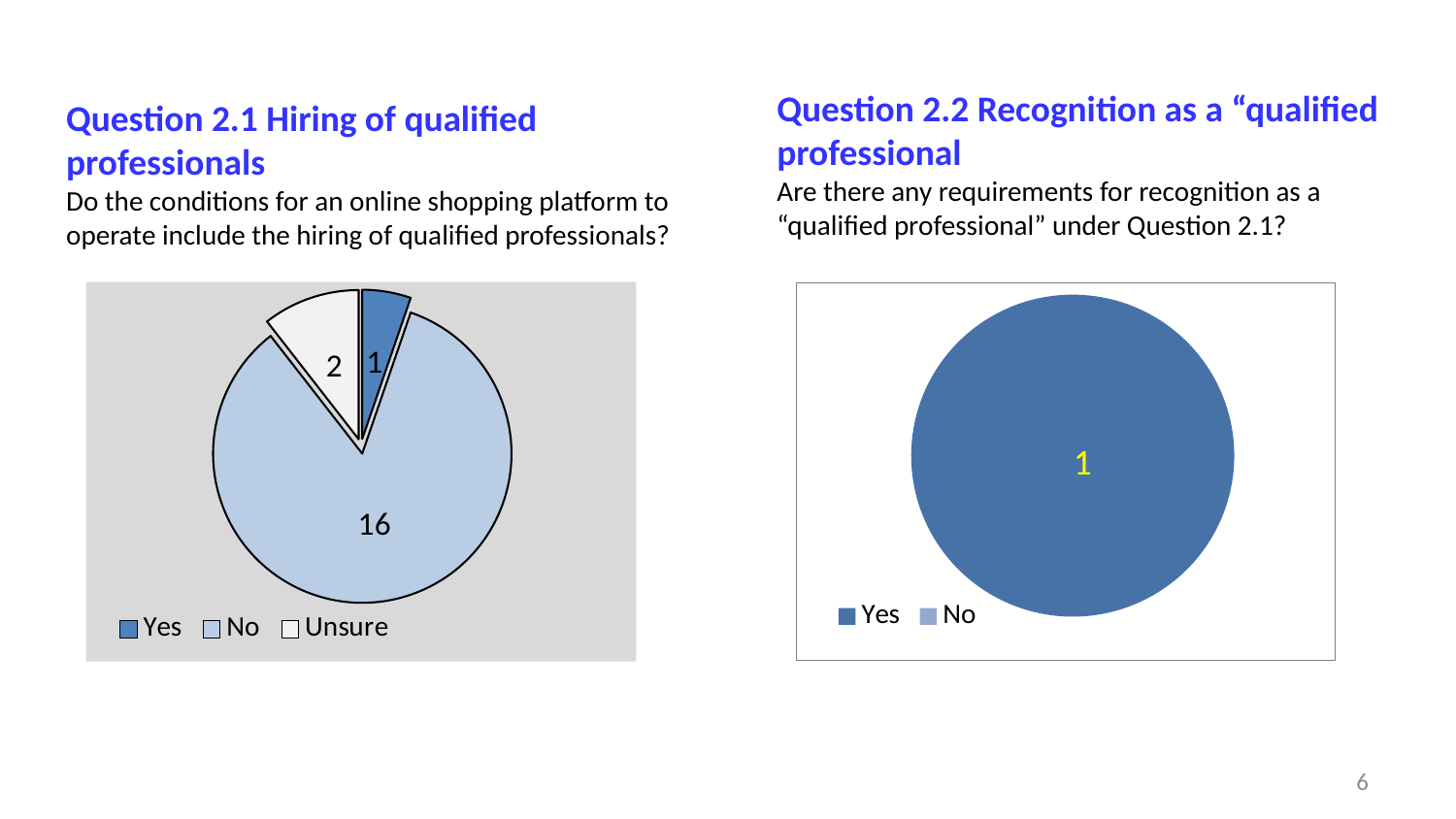
In the Question 2.1 chart on the left, which category has the largest slice? No In the Question 2.1 chart on the left, what is the value for "Unsure"? 2 In the Question 2.1 chart on the left, which category has the smallest slice? Yes In the Question 2.1 chart on the left, what is the value for "No"? 16 How many entries does the legend of the Question 2.2 chart on the right list? 2 How many categories does the legend of the Question 2.1 chart on the left list? 3 In the Question 2.1 chart on the left, what is the total of all slices? 19 What kind of chart is used for Question 2.2 on the right? Pie chart In the Question 2.1 chart on the left, what is the difference between the "No" and "Unsure" values? 14 In the Question 2.1 chart on the left, which is larger, "Unsure" or "Yes"? Unsure In the Question 2.2 chart on the right, what is the value shown for "Yes"? 1 In the Question 2.1 chart on the left, what is the value for "Yes"? 1